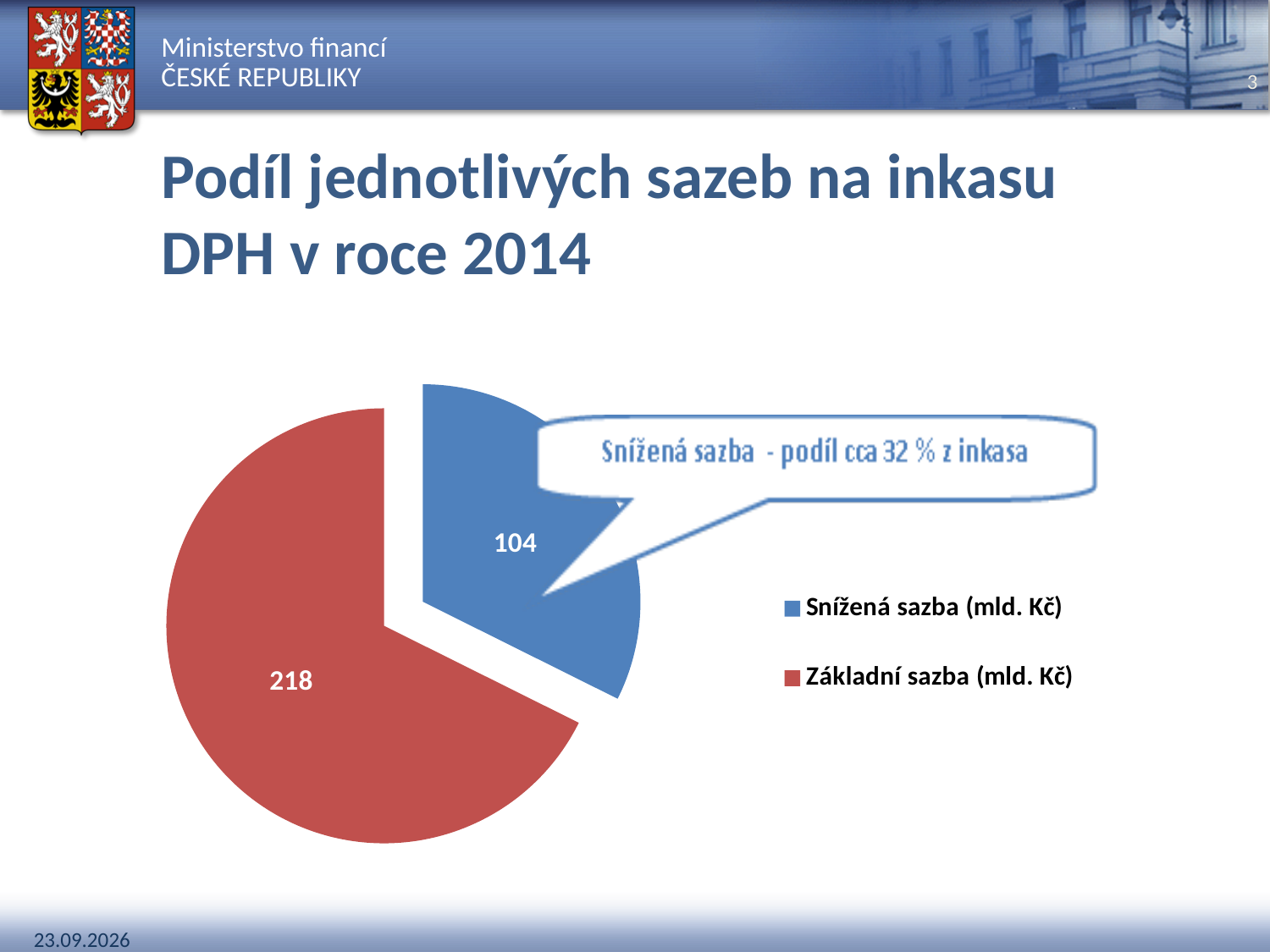
Which slice of the pie is the smallest? Snížená sazba (mld. Kč) What colour is the slice for Základní sazba (mld. Kč)? red What type of chart is shown on the slide? pie chart According to the callout on the chart, what share of the collection does Snížená sazba represent? cca 32 % What is the value for Základní sazba (mld. Kč)? 218 Which is larger, the value for Snížená sazba or the value for Základní sazba? Základní sazba How many entries does the legend list? 2 Which slice of the pie is the largest? Základní sazba (mld. Kč) How many slices does the pie chart have? 2 What is the total of the two values shown in the pie chart? 322 What is the value for Snížená sazba (mld. Kč)? 104 What is the difference between the values for Základní sazba and Snížená sazba? 114